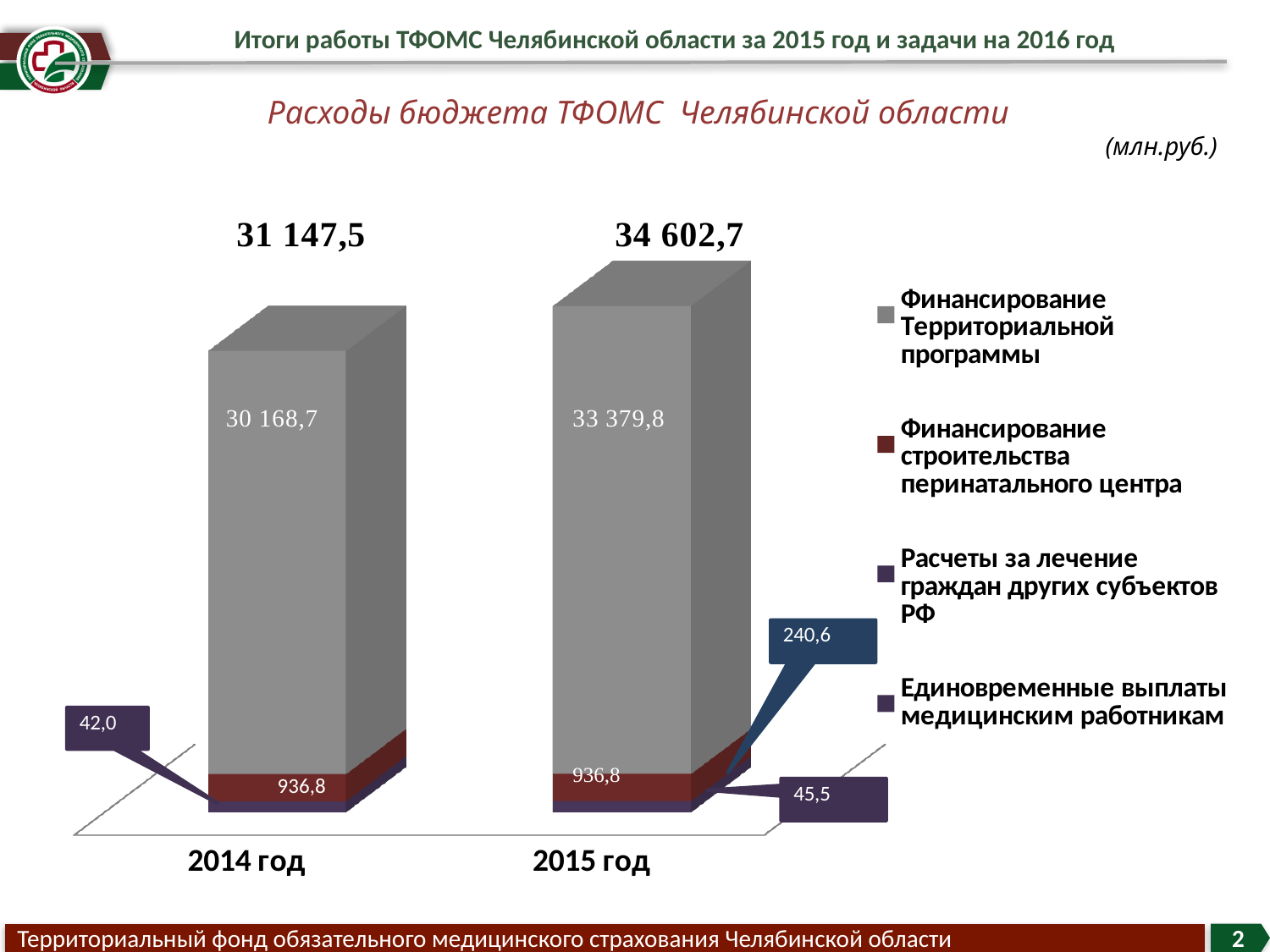
Which year has the larger value for Единовременные выплаты медицинским работникам, 2014 год or 2015 год? 2015 год What is the value for Финансирование строительства перинатального центра in 2015 год? 936,8 What is the value for Единовременные выплаты медицинским работникам in 2014 год? 42,0 How many categories are shown on the x axis? 2 What is the value for Расчеты за лечение граждан других субъектов РФ in 2015 год? 240,6 What is the total of the stacked bar for 2014 год? 31 147,5 What is the total of the stacked bar for 2015 год? 34 602,7 What is the value for Финансирование Территориальной программы in 2014 год? 30 168,7 What is the difference between the Финансирование Территориальной программы values for 2015 год and 2014 год? 3 211,1 What kind of chart is shown on the slide? Stacked bar chart How many series does the legend list? 4 What is the value for Финансирование Территориальной программы in 2015 год? 33 379,8